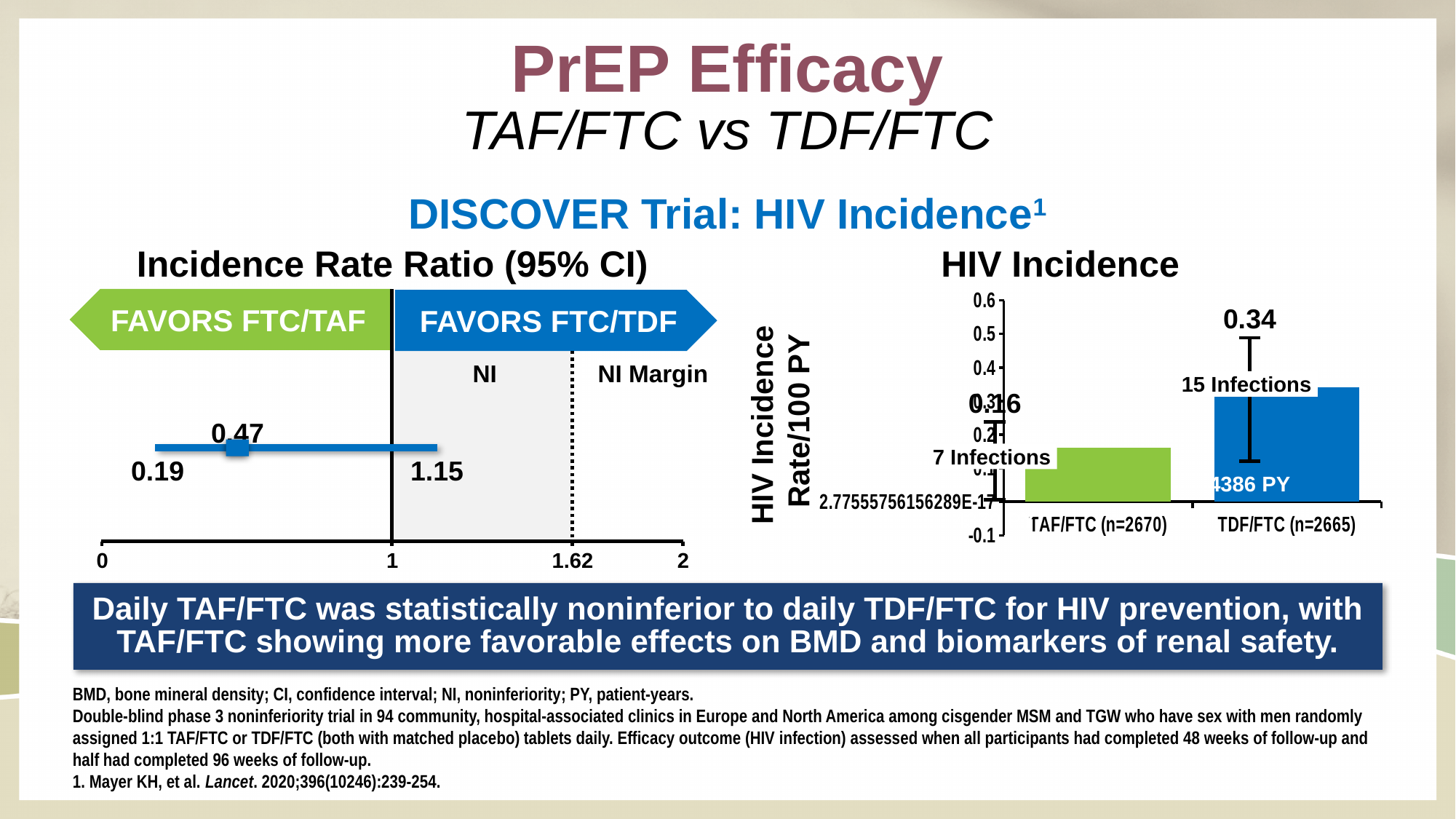
In the HIV Incidence chart, how many infections are shown for the TAF/FTC (n=2670) group? 7 Infections In the Incidence Rate Ratio (95% CI) chart, what are the lower and upper bounds of the 95% CI? 0.19 and 1.15 In the HIV Incidence chart, what is the HIV incidence rate per 100 PY for TDF/FTC (n=2665)? 0.34 In the Incidence Rate Ratio (95% CI) chart, what is the point estimate of the incidence rate ratio? 0.47 In the HIV Incidence chart, which group has the lower HIV incidence rate? TAF/FTC (n=2670) In the HIV Incidence chart, how many groups are plotted? 2 What kind of chart is the HIV Incidence chart? Bar chart In the HIV Incidence chart, which group has the higher HIV incidence rate? TDF/FTC (n=2665) In the HIV Incidence chart, how many infections are shown for the TDF/FTC (n=2665) group? 15 Infections In the HIV Incidence chart, is the incidence rate for TAF/FTC (n=2670) greater or less than 0.2? less In the Incidence Rate Ratio (95% CI) chart, at what value is the NI Margin drawn? 1.62 In the HIV Incidence chart, how many more infections occurred in the TDF/FTC group than in the TAF/FTC group? 8